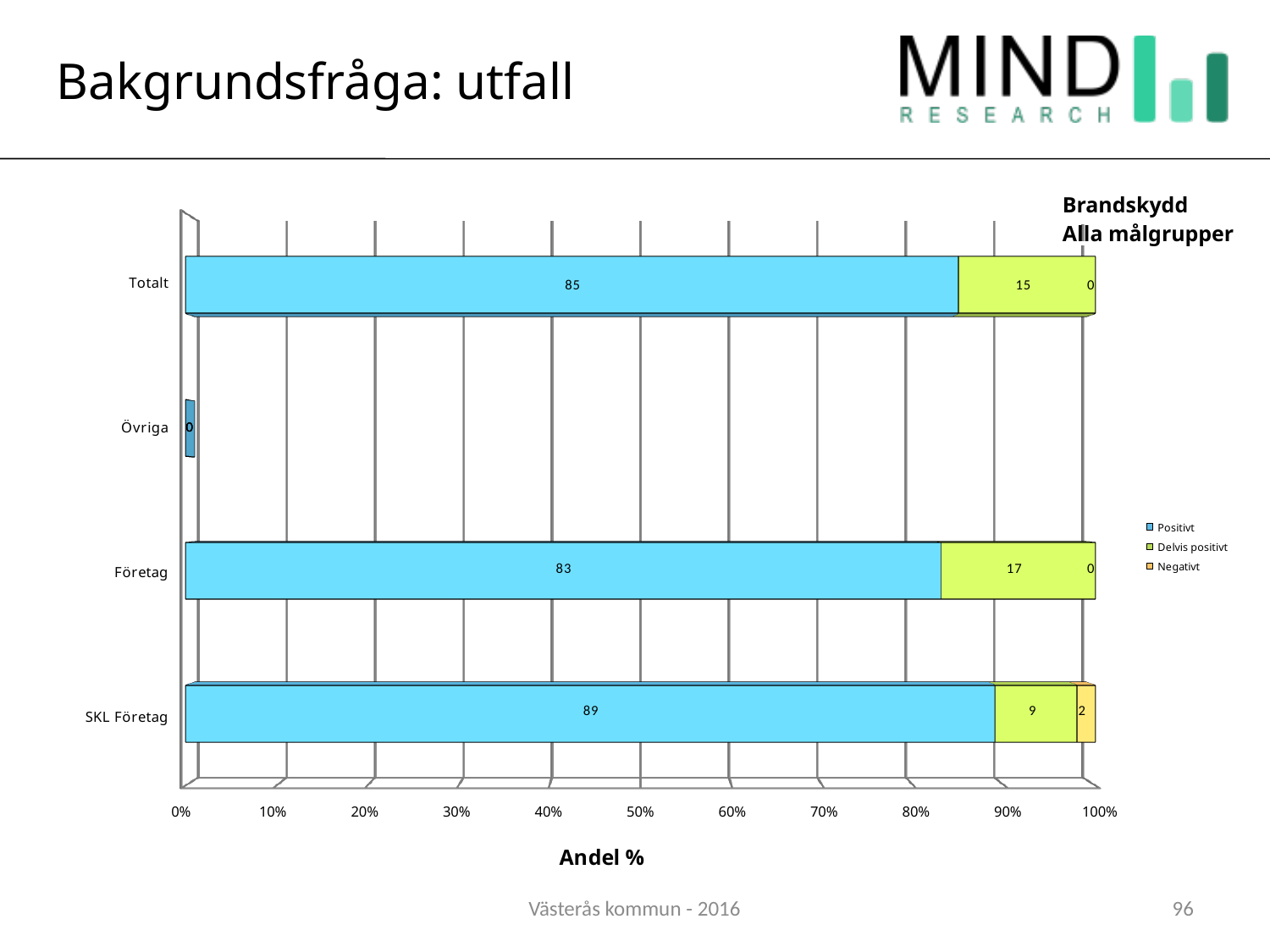
What is the difference between the Positivt values for SKL Företag and Företag? 6 What is the Delvis positivt value for SKL Företag? 9 What is the label of the x axis? Andel % How many categories are shown on the y axis? 4 Which category has the highest Positivt value? SKL Företag Is the Positivt value for Totalt larger than the Positivt value for Företag? Yes What is the Positivt value for Totalt? 85 What is the Delvis positivt value for Företag? 17 What is the Negativt value for SKL Företag? 2 Which category has the highest Delvis positivt value? Företag What kind of chart is shown on the slide? Stacked bar chart How many series does the legend list? 3